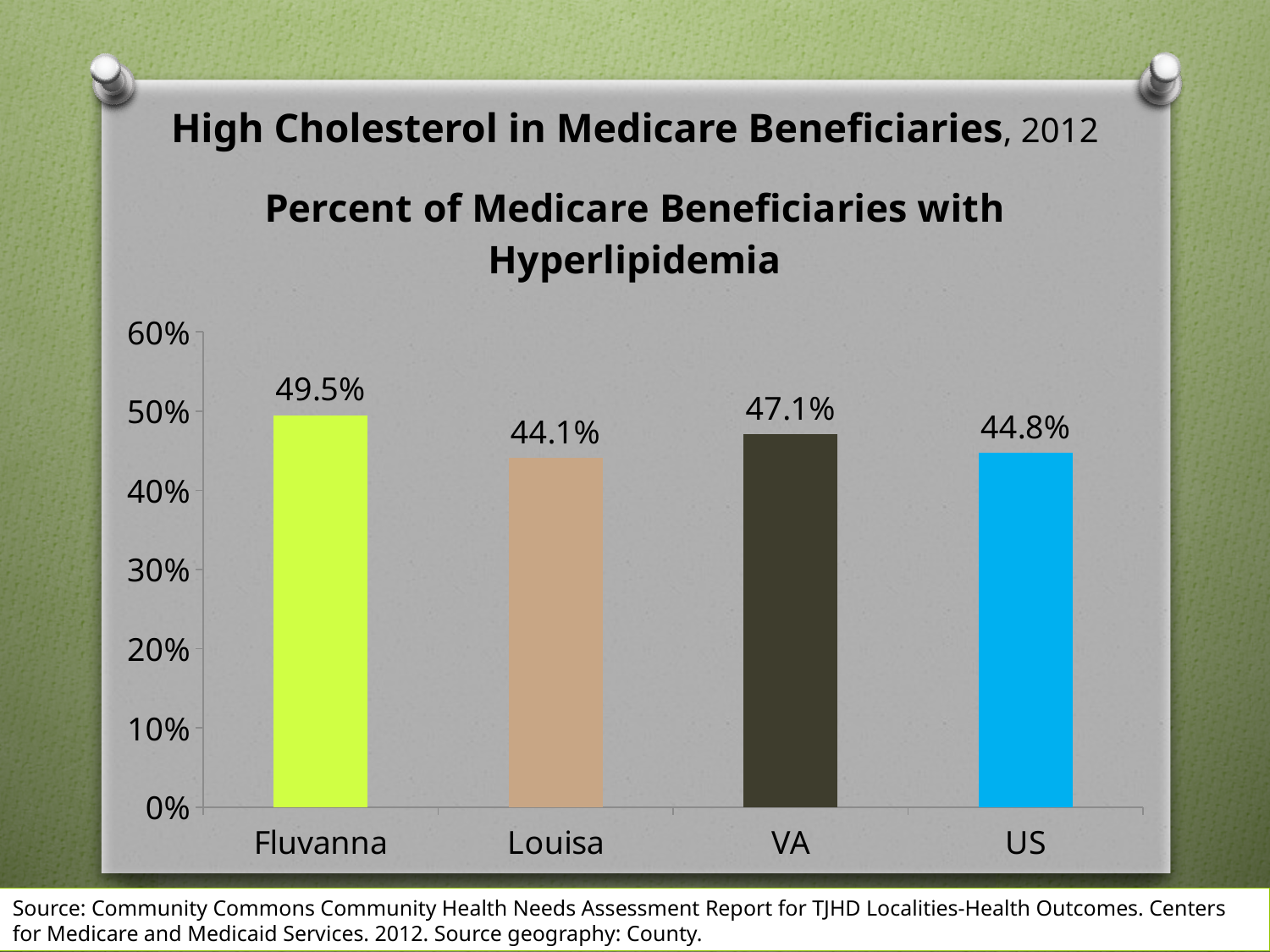
What is the difference in percentage points between Fluvanna and Louisa? 5.4 What is the percent of Medicare beneficiaries with hyperlipidemia in Fluvanna? 49.5% What is the percent of Medicare beneficiaries with hyperlipidemia in Louisa? 44.1% What is the title of the chart? Percent of Medicare Beneficiaries with Hyperlipidemia Which category has the highest percent of Medicare beneficiaries with hyperlipidemia? Fluvanna Which has a higher value, Fluvanna or VA? Fluvanna What kind of chart is shown on the slide? Bar chart What is the difference in percentage points between VA and US? 2.3 How many categories are shown on the chart? 4 Which category has the lowest percent of Medicare beneficiaries with hyperlipidemia? Louisa What is the value shown for VA? 47.1% What is the value shown for US? 44.8%